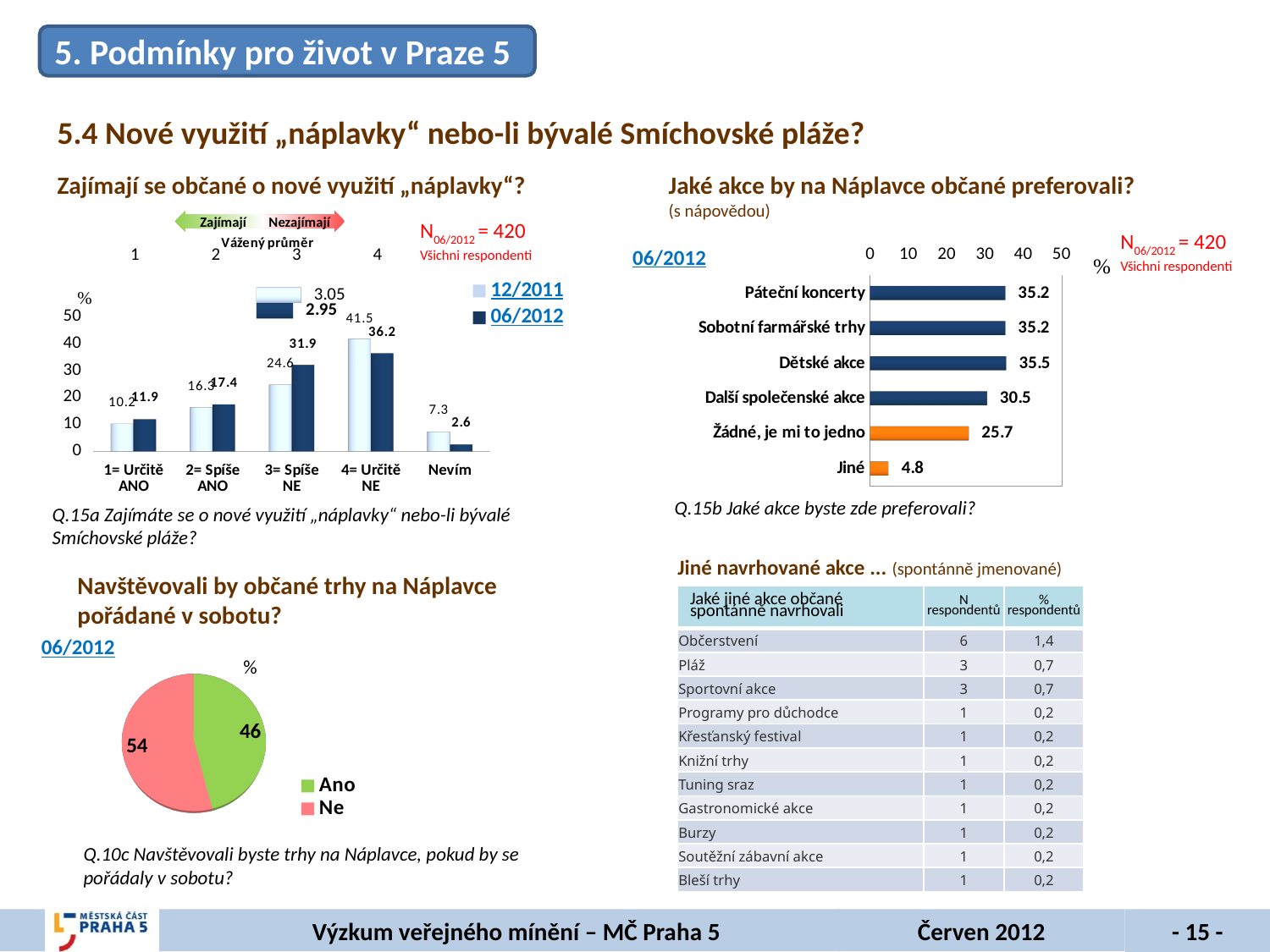
In the chart "Zajímají se občané o nové využití „náplavky“?", which category has the highest 06/2012 value? 4= Určitě NE In the chart "Zajímají se občané o nové využití „náplavky“?", what is the difference between the 12/2011 and 06/2012 values for 3= Spíše NE? 7.3 In the chart "Jaké akce by na Náplavce občané preferovali?", how many categories are shown? 6 In the chart "Zajímají se občané o nové využití „náplavky“?", what is the 12/2011 value for 4= Určitě NE? 41.5 In the chart "Jaké akce by na Náplavce občané preferovali?", what is the value for Další společenské akce? 30.5 In the pie chart "Navštěvovali by občané trhy na Náplavce pořádané v sobotu?", what is the value for Ne? 54 In the chart "Jaké akce by na Náplavce občané preferovali?", what is the difference between Žádné, je mi to jedno and Jiné? 20.9 In the chart "Zajímají se občané o nové využití „náplavky“?", is the 12/2011 value for Nevím larger or the 06/2012 value for Nevím? 12/2011 What kind of chart is "Navštěvovali by občané trhy na Náplavce pořádané v sobotu?"? pie chart In the chart "Zajímají se občané o nové využití „náplavky“?", what is the 06/2012 value for 3= Spíše NE? 31.9 In the chart "Zajímají se občané o nové využití „náplavky“?", how many series does the legend list? 2 In the chart "Jaké akce by na Náplavce občané preferovali?", which category has the lowest value? Jiné